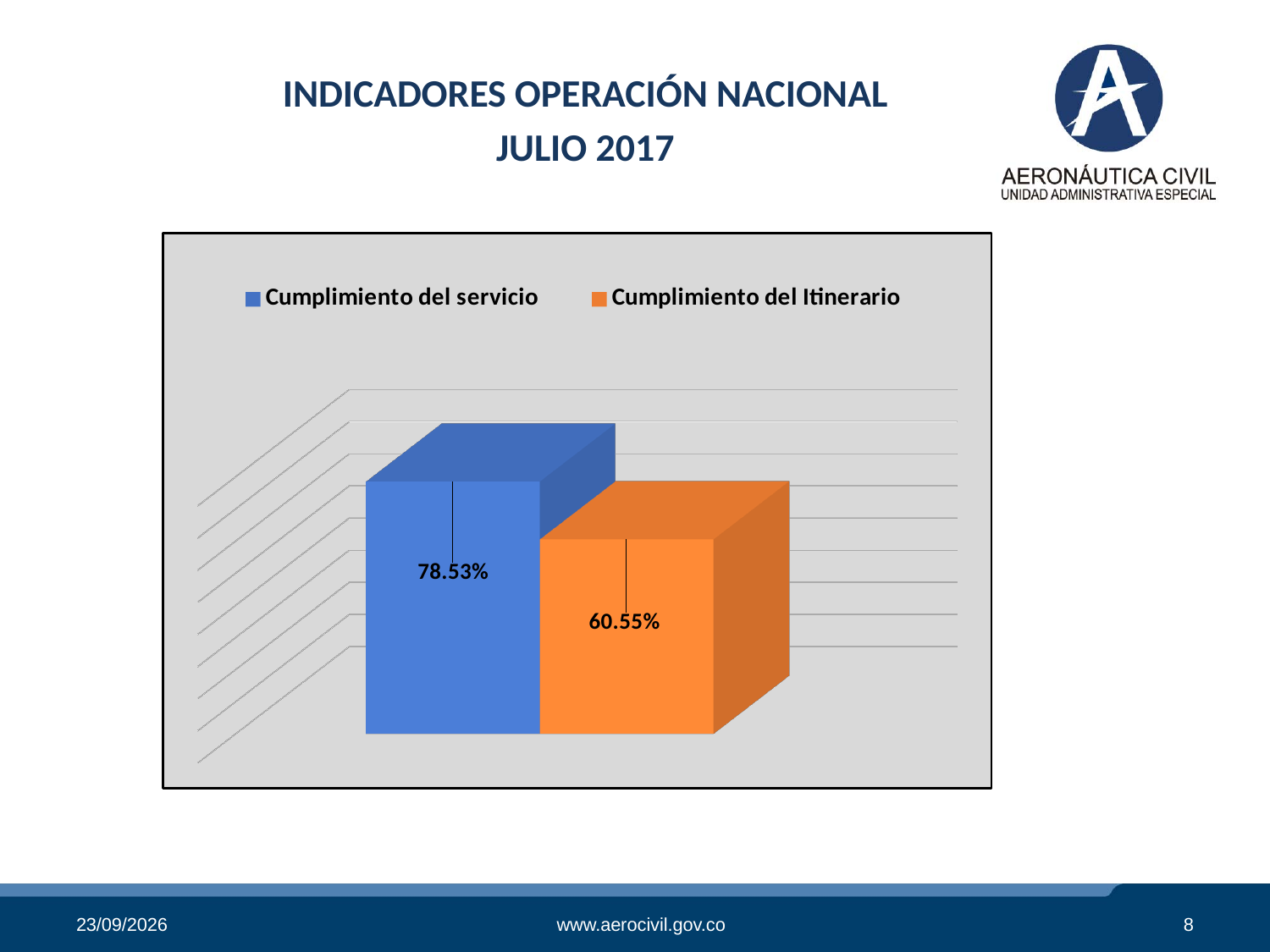
What is the value for Cumplimiento del servicio? 78.53% What colour is the bar for Cumplimiento del Itinerario? Orange What kind of chart is shown on the slide? Bar chart Which series has the highest value? Cumplimiento del servicio Which is larger, Cumplimiento del servicio or Cumplimiento del Itinerario? Cumplimiento del servicio How many bars are plotted in the chart? 2 How many series does the legend list? 2 What is the difference between Cumplimiento del servicio and Cumplimiento del Itinerario? 17.98% Which series has the lowest value? Cumplimiento del Itinerario What is the value for Cumplimiento del Itinerario? 60.55% What colour is the bar for Cumplimiento del servicio? Blue